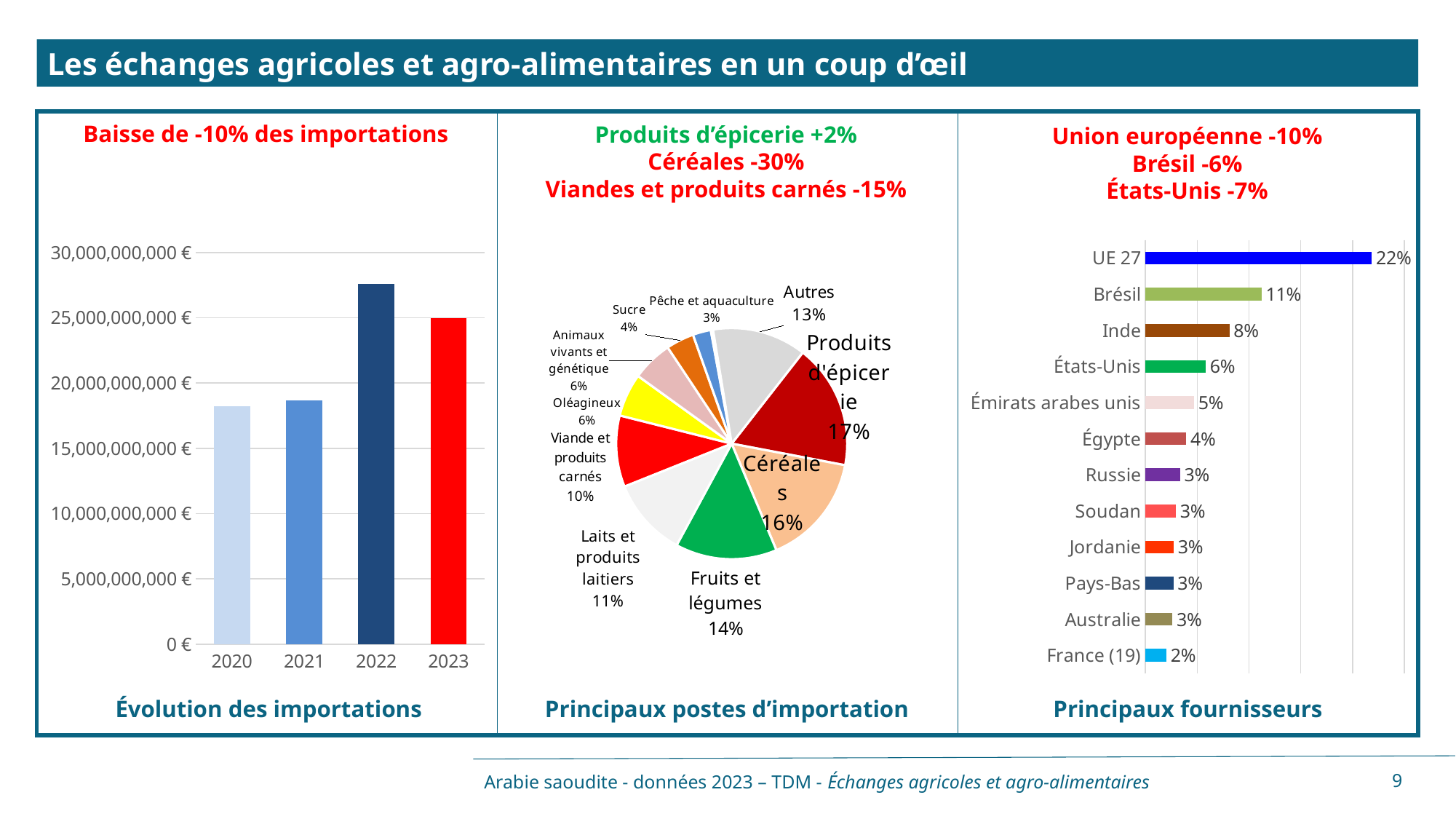
In the 'Évolution des importations' chart, how many years are plotted? 4 In the 'Évolution des importations' chart, is the value for 2022 greater or less than 25,000,000,000 €? greater What kind of chart is 'Principaux postes d'importation'? pie chart In the 'Évolution des importations' chart, do the values rise or fall from 2022 to 2023? fall In the 'Principaux fournisseurs' chart, what is the value for Brésil? 11% In the 'Évolution des importations' chart, is the value for 2020 greater or less than 20,000,000,000 €? less In the 'Principaux fournisseurs' chart, which supplier has the lowest value? France (19) In the 'Évolution des importations' chart, which year has the highest bar? 2022 In the 'Principaux fournisseurs' chart, which is larger, Inde or États-Unis? Inde In the 'Principaux postes d'importation' pie chart, what is the difference between Céréales and Fruits et légumes? 2% In the 'Principaux postes d'importation' pie chart, which category has the smallest slice? Pêche et aquaculture In the 'Principaux postes d'importation' pie chart, what share do Céréales have? 16%